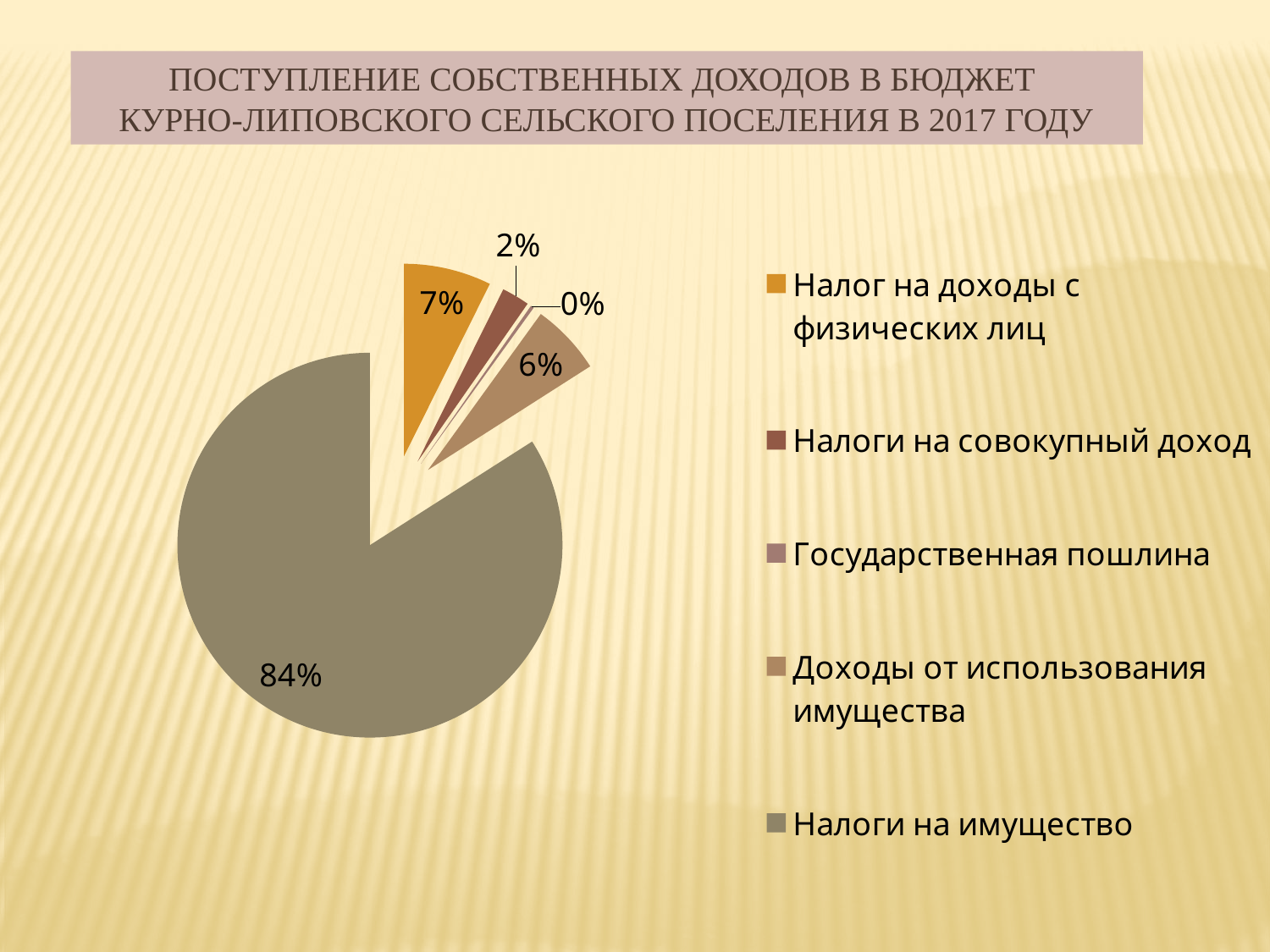
What kind of chart is shown on the slide? Pie chart Which is larger: the share for "Налог на доходы с физических лиц" or the share for "Доходы от использования имущества"? Налог на доходы с физических лиц What share of the pie does "Доходы от использования имущества" have? 6% How many categories does the legend list? 5 What is the difference in percentage points between "Налоги на имущество" and "Налог на доходы с физических лиц"? 77 Which year does the chart title refer to? 2017 Which category has the largest slice of the pie? Налоги на имущество What share of the pie does "Налоги на совокупный доход" have? 2% What share of the pie does "Налоги на имущество" have? 84% Which category has the smallest slice of the pie? Государственная пошлина